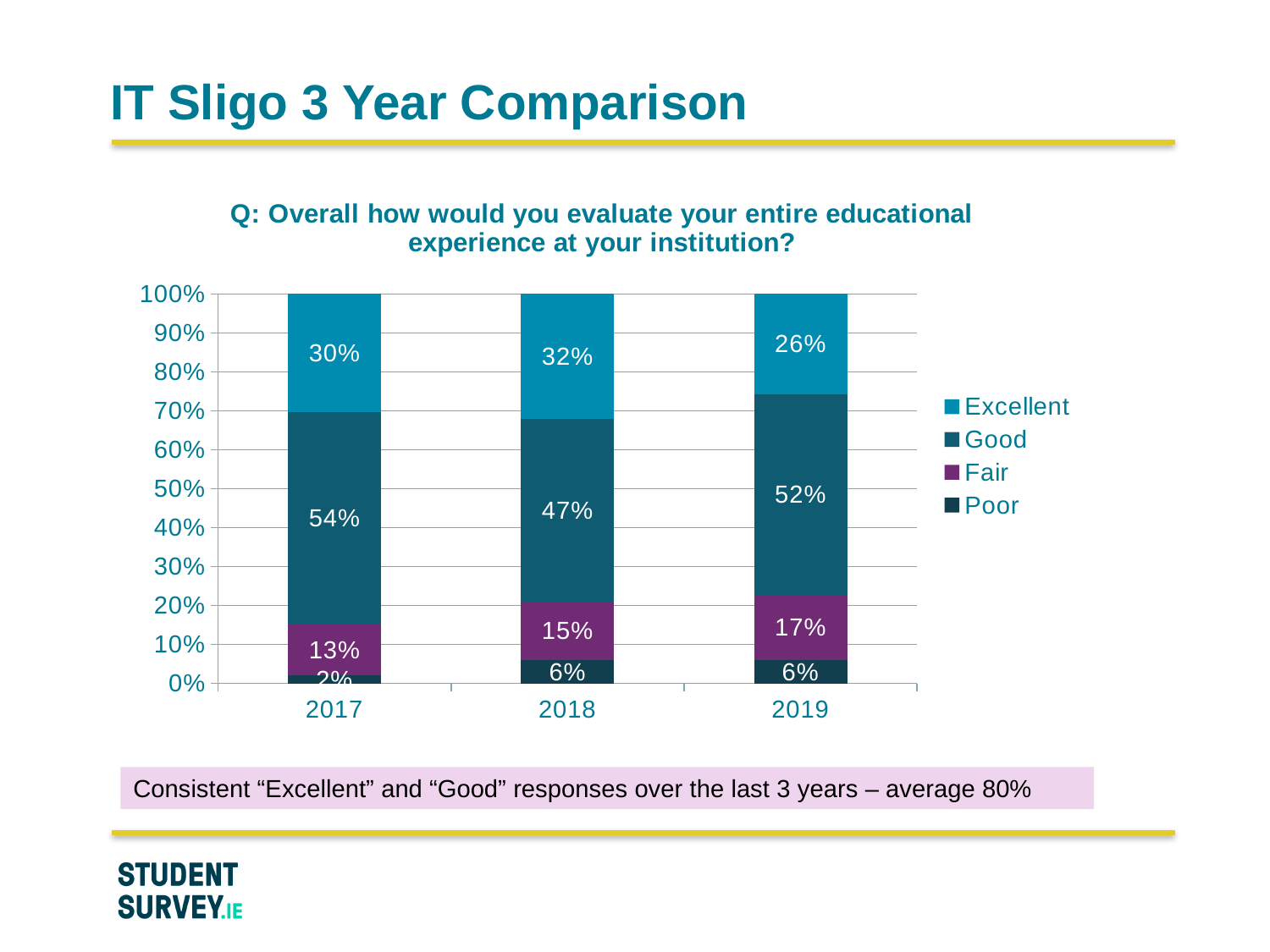
In which year was the Good share lowest? 2018 What kind of chart is shown on the slide? Stacked bar chart Does the Fair share rise or fall from 2017 to 2019? Rise What is the Fair value for 2017? 13% What percentage of respondents rated their experience as Excellent in 2018? 32% What is the Good value for 2019? 52% How many years are shown on the x axis? 3 How many series does the legend list? 4 Which is larger, the Fair value for 2018 or the Fair value for 2019? 2019 What is the Poor value for 2019? 6% In which year was the Excellent share highest? 2018 What is the difference between the Good values for 2017 and 2018? 7%